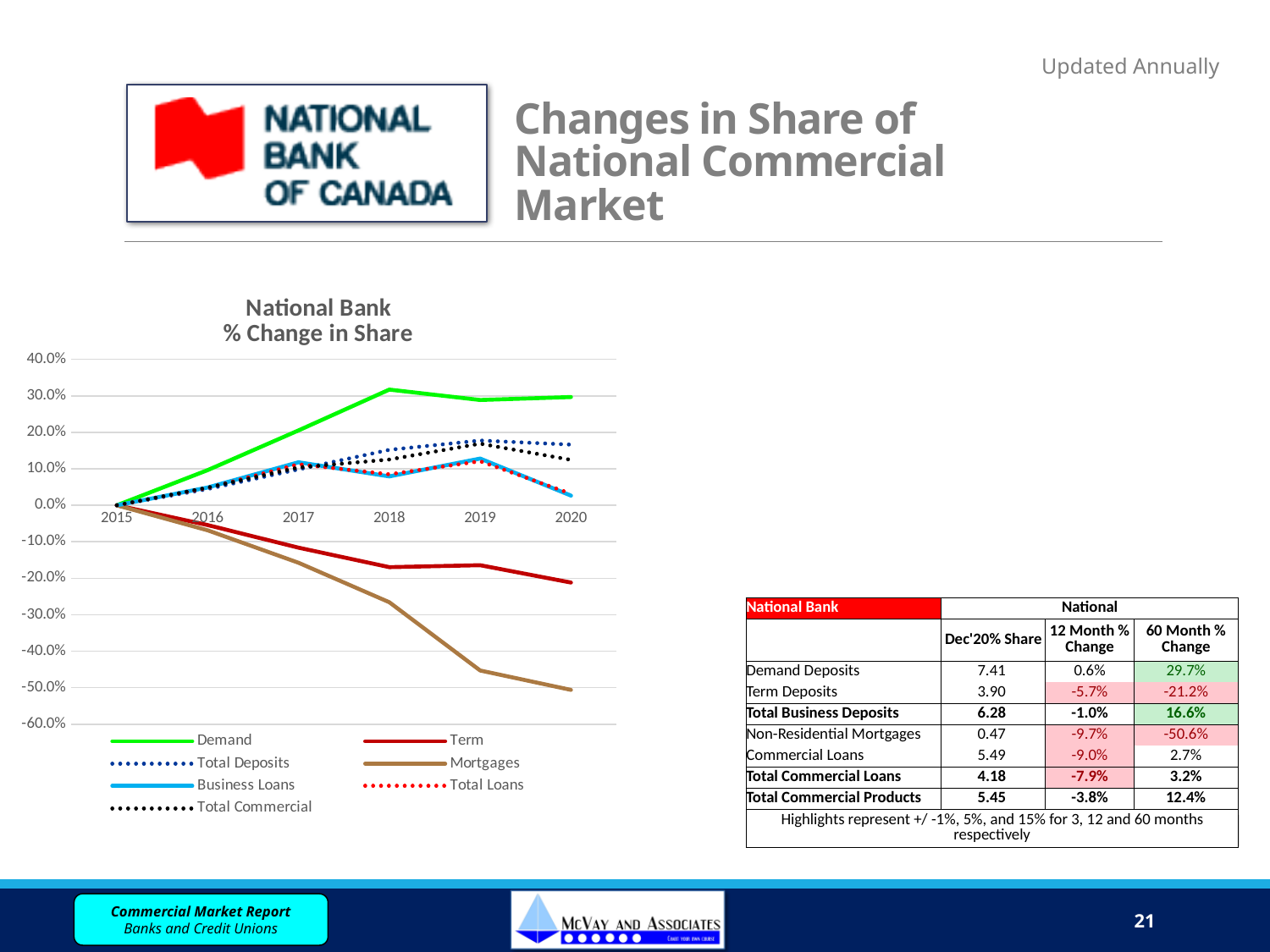
In 2019, which is larger: the value for Demand or the value for Term? Demand Is the value for Term in 2020 greater or less than -10.0%? less What kind of chart is shown on the slide? line chart Which series is plotted with a green line? Demand What is the title of the chart? National Bank % Change in Share How many series does the chart legend list? 7 Do the values for Mortgages rise or fall from 2015 to 2020? fall Is the value for Demand in 2020 greater or less than 20.0%? greater How many years are shown along the x axis of the chart? 6 Which series has the highest value in 2020? Demand Which series has the lowest value in 2020? Mortgages Is the value for Mortgages in 2020 greater or less than -40.0%? less